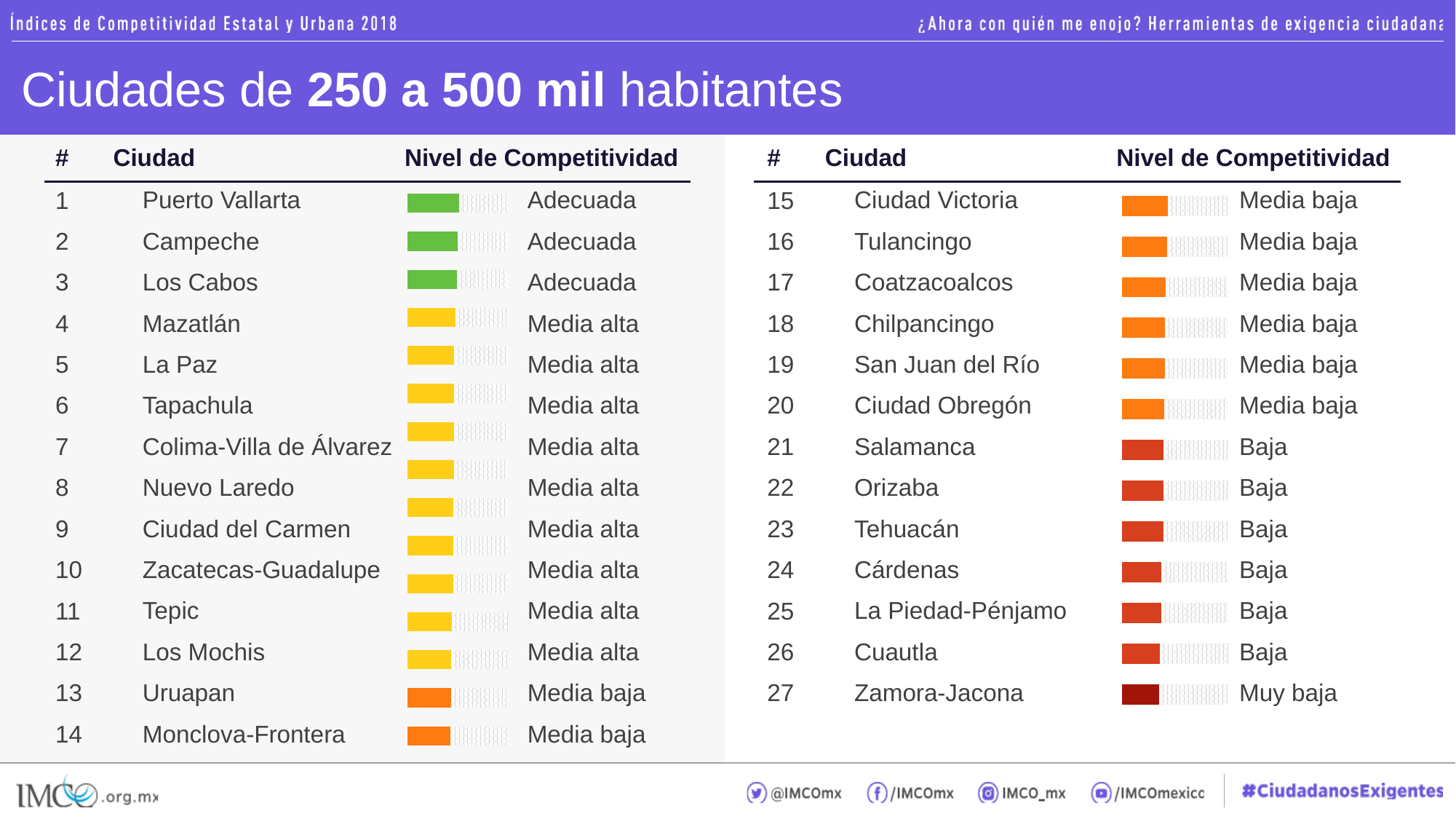
Which city is ranked higher, Campeche or Tepic? Campeche What is the competitiveness level shown for Mazatlán? Media alta How many cities are rated 'Adecuada'? 3 What is the competitiveness level (Nivel de Competitividad) shown for Puerto Vallarta? Adecuada What is the competitiveness level shown for Uruapan? Media baja Which city has the level 'Muy baja'? Zamora-Jacona Which city is ranked number 1 in the list? Puerto Vallarta How many cities are listed on the slide in total? 27 Which city is ranked last (number 27) in the list? Zamora-Jacona What is the competitiveness level shown for Salamanca? Baja What rank does Ciudad Obregón hold in the list? 20 What colour are the bars for cities rated 'Baja'? Red